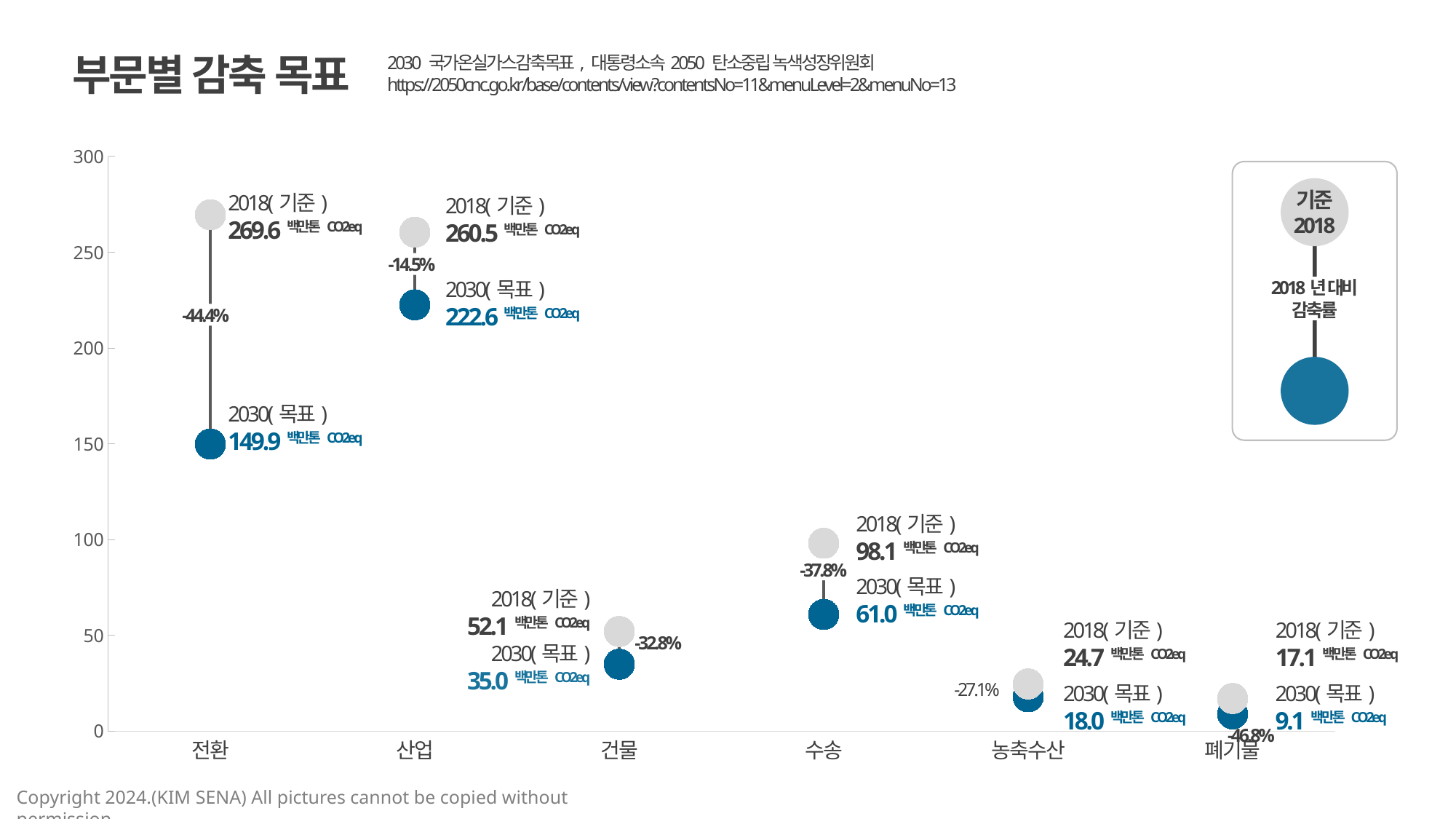
Which is larger, the 2030 target for 전환 or the 2030 target for 산업? 산업 Which sector has the highest 2018 baseline value? 전환 What colour are the 2030 target markers? Blue What is the 2018 baseline value for 전환? 269.6 백만톤 CO2eq How many sectors are shown on the x axis? 6 What reduction rate versus 2018 is shown for 수송? -37.8% Which sector has the lowest 2030 target value? 폐기물 What is the 2030 target value for 산업? 222.6 백만톤 CO2eq Is the 2018 baseline value for 수송 greater or less than 100? less Which sector shows the largest percentage reduction versus 2018? 폐기물 What is the 2030 target value for 폐기물? 9.1 백만톤 CO2eq What is the difference between the 2018 baseline and the 2030 target for 건물? 17.1